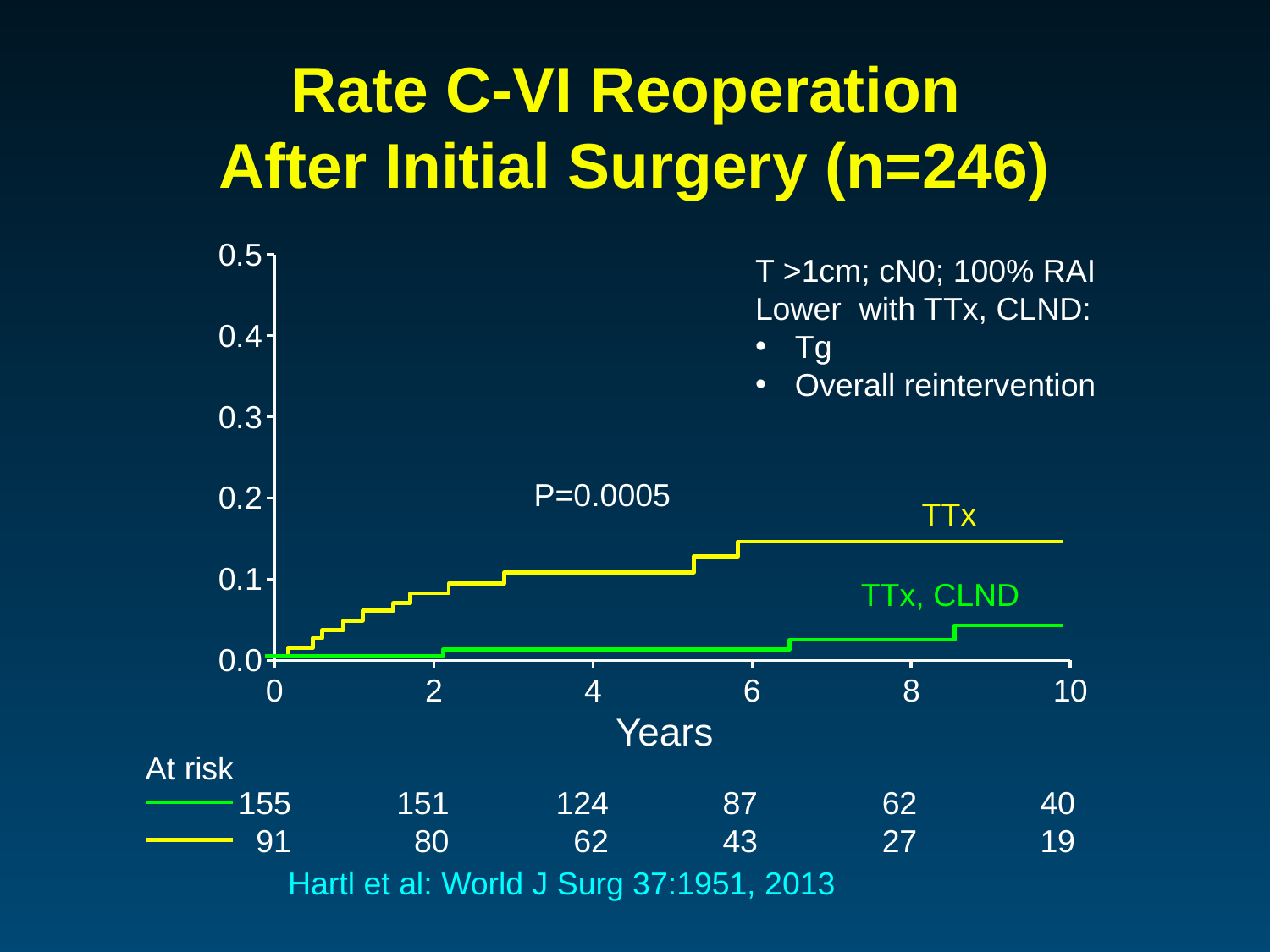
How many series (curves) are plotted on the chart? 2 What is the difference between the number at risk in the green group and the yellow group at year 10? 21 Do the curves rise or fall as years increase? rise Is the value of the TTx curve at 10 years greater or less than 0.2? less Is the value of the TTx curve at 10 years greater or less than 0.1? greater What kind of chart is shown on the slide? line chart How many patients are at risk in the TTx (yellow) group at year 6? 43 What is the label of the x axis? Years Is the value of the TTx, CLND curve at 10 years greater or less than 0.1? less At 8 years, which curve is higher, TTx or TTx, CLND? TTx What is the P value printed on the chart? P=0.0005 How many patients are at risk in the TTx, CLND (green) group at year 0? 155